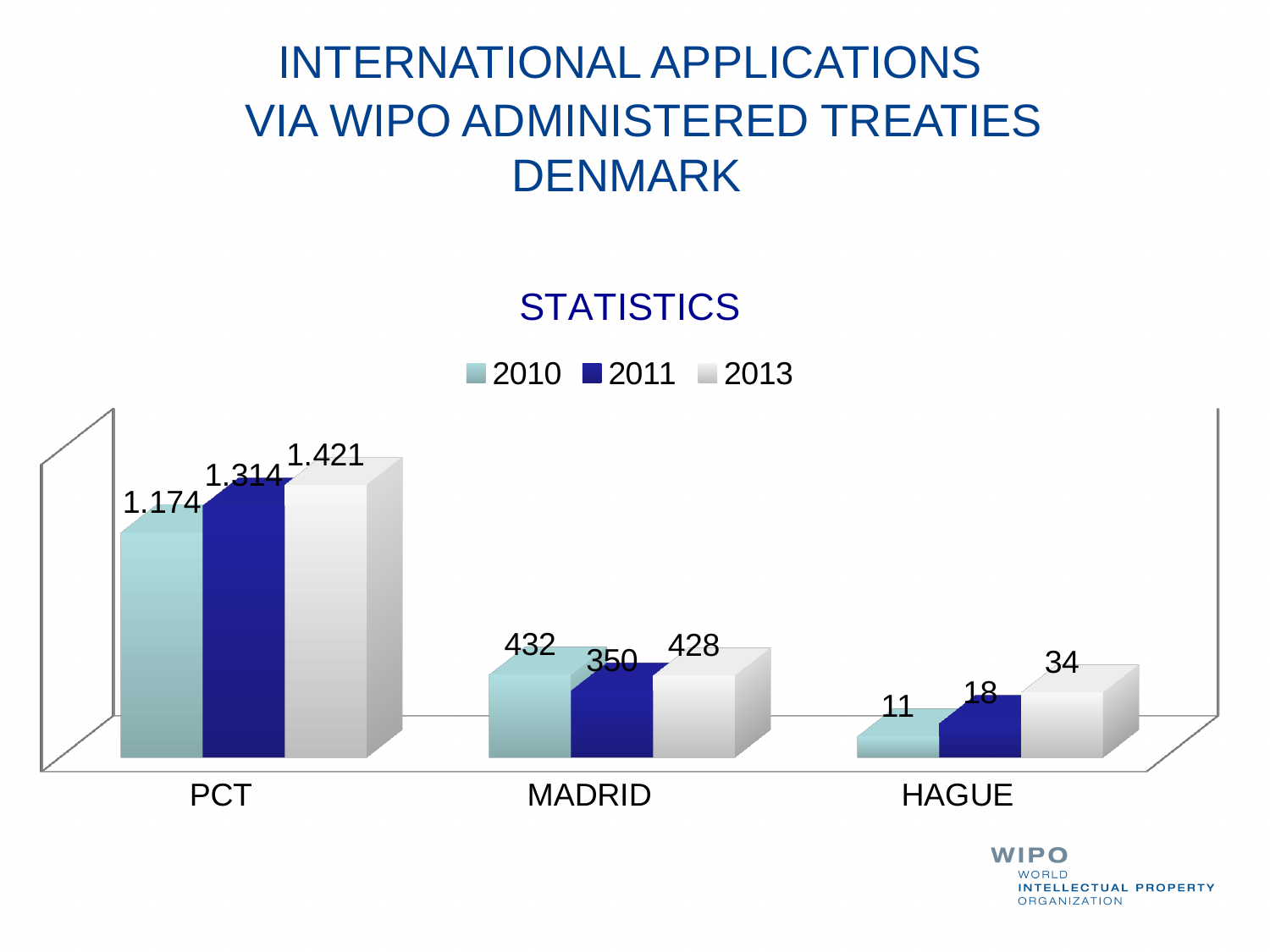
What is the value for HAGUE in 2013? 34 Which category has the highest value in 2013? PCT What kind of chart is shown on the slide? Bar chart What is the value for PCT in 2010? 1.174 Do the values for HAGUE rise or fall from 2010 to 2013? Rise Which is larger for MADRID, the 2010 value or the 2013 value? 2010 Which category has the lowest value in 2010? HAGUE How many categories are shown on the x axis? 3 How many series does the legend list? 3 What is the difference between the 2013 and 2010 values for PCT? 247 What is the value for MADRID in 2011? 350 What is the difference between the 2010 and 2011 values for MADRID? 82